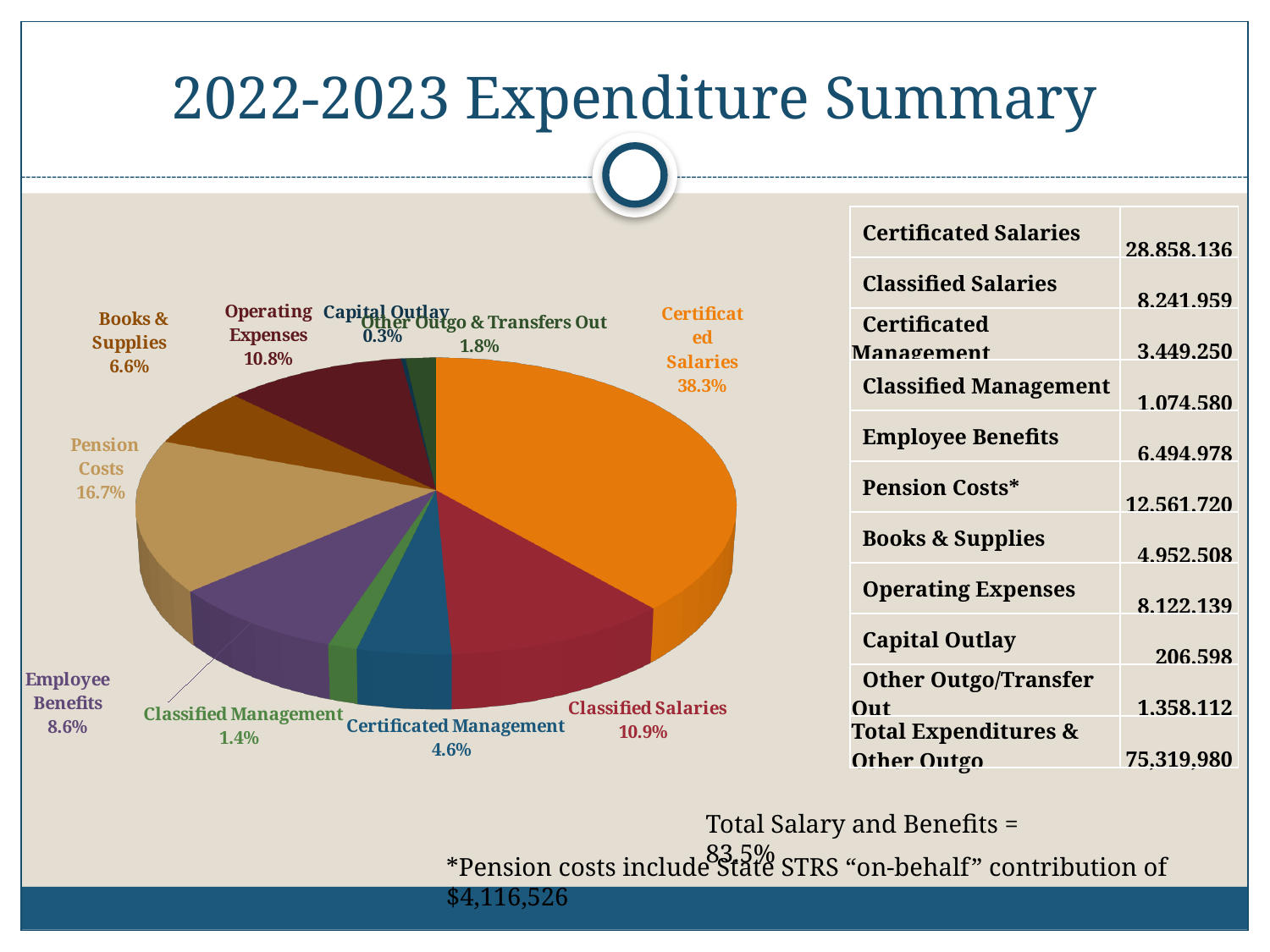
What is the title of the slide containing the pie chart? 2022-2023 Expenditure Summary What is the percentage shown for Employee Benefits? 8.6% Which category has the largest slice of the pie? Certificated Salaries What is the percentage shown for Other Outgo & Transfers Out? 1.8% How many slices does the pie chart have? 10 Which category has the smallest slice of the pie? Capital Outlay What is the percentage shown for Classified Management? 1.4% What share of the pie does Certificated Salaries represent? 38.3% Which is larger, the share for Books & Supplies or the share for Employee Benefits? Employee Benefits What is the percentage shown for Pension Costs? 16.7% What is the difference in percentage points between Classified Salaries and Certificated Management? 6.3% What kind of chart is shown on the slide? pie chart